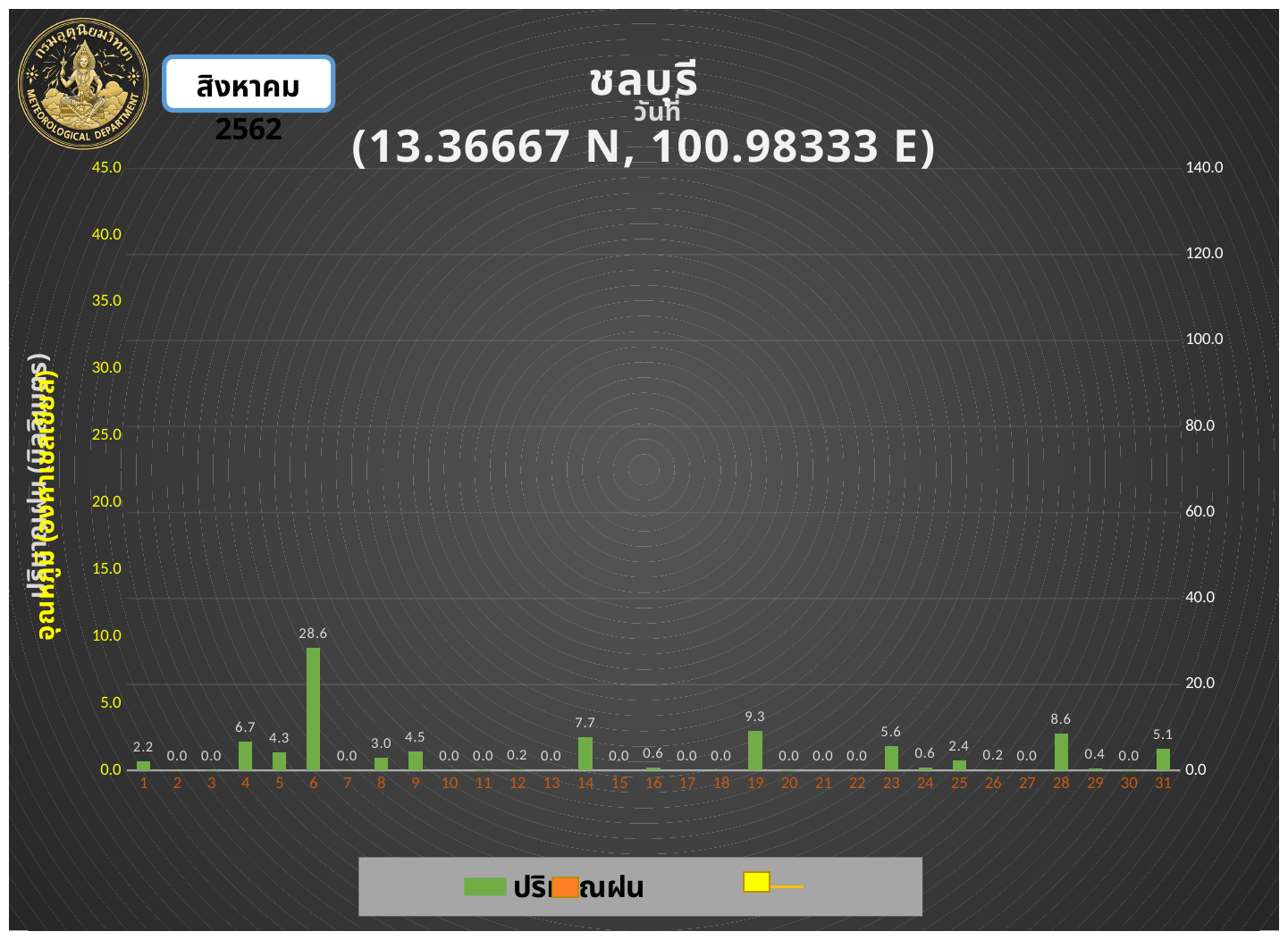
What is the rainfall value shown for day 28? 8.6 What is the difference between the rainfall values for day 4 and day 5? 2.4 How many days (categories) are shown on the x axis? 31 What is the rainfall value shown for day 6? 28.6 Which day has the highest rainfall value? 6 What coordinates are given in the chart title? 13.36667 N, 100.98333 E What is the rainfall value shown for day 31? 5.1 What is the rainfall value shown for day 19? 9.3 What kind of chart is shown on the slide? bar chart Which has the larger rainfall value, day 14 or day 23? day 14 What is the difference between the rainfall values for day 6 and day 19? 19.3 Which has the larger rainfall value, day 28 or day 31? day 28